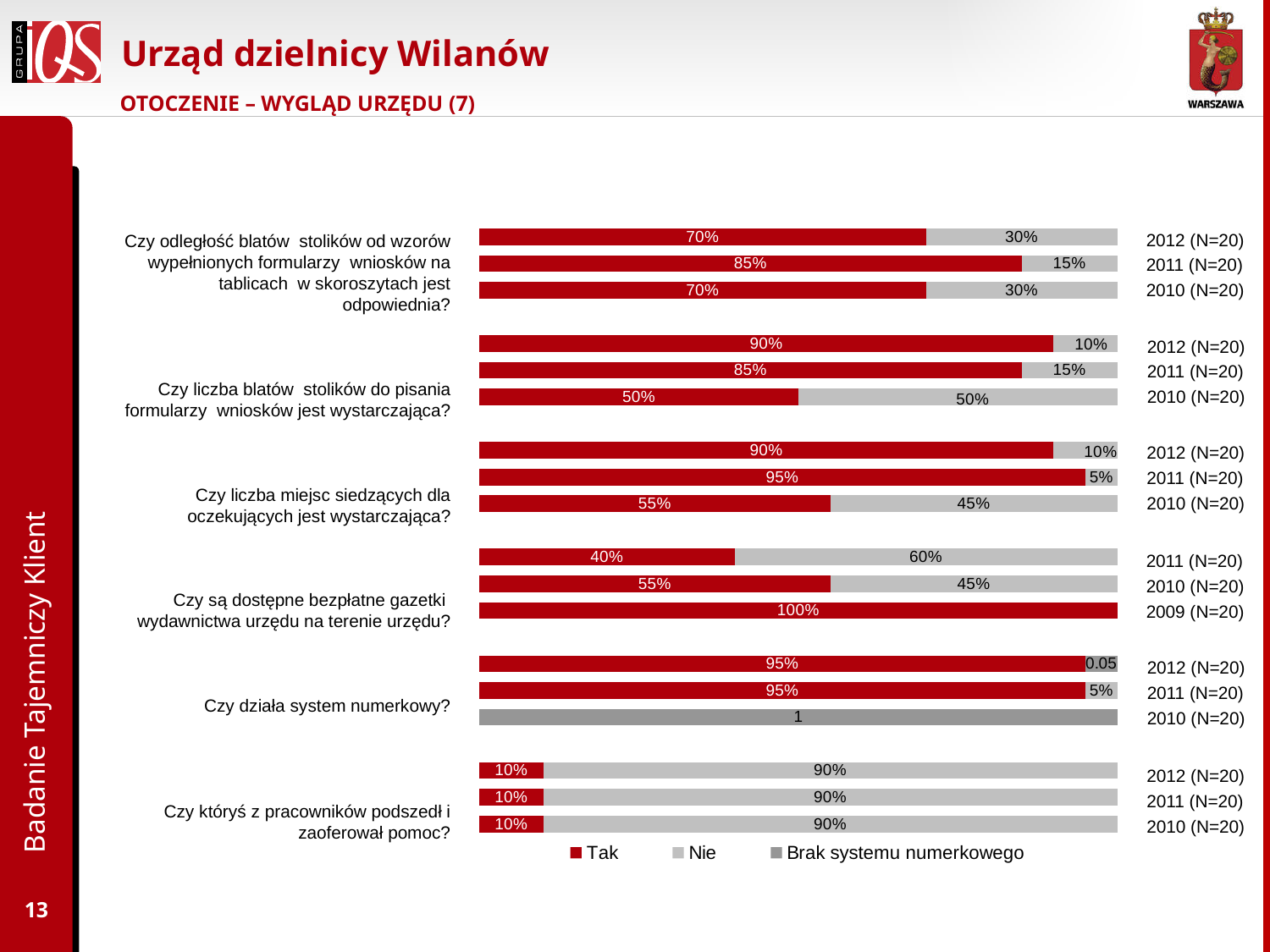
For the question "Czy liczba blatów stolików do pisania formularzy wniosków jest wystarczająca?", what is the Nie value for 2010 (N=20)? 50% For the question "Czy liczba miejsc siedzących dla oczekujących jest wystarczająca?", what is the Tak value for 2011 (N=20)? 95% For the question "Czy odległość blatów stolików od wzorów wypełnionych formularzy wniosków na tablicach w skoroszytach jest odpowiednia?", what is the Tak value for 2011 (N=20)? 85% What kind of chart is shown on the slide? Stacked bar chart For the question "Czy któryś z pracowników podszedł i zaoferował pomoc?", what is the Nie value for 2012 (N=20)? 90% For the question "Czy liczba blatów stolików do pisania formularzy wniosków jest wystarczająca?", does the Tak value rise or fall from 2010 to 2012? Rises For the question "Czy liczba blatów stolików do pisania formularzy wniosków jest wystarczająca?", what is the difference between the Tak value for 2012 and the Tak value for 2010? 40 percentage points For the question "Czy odległość blatów stolików od wzorów wypełnionych formularzy wniosków na tablicach w skoroszytach jest odpowiednia?", which year has the highest Tak value? 2011 How many series does the chart legend list? 3 Which colour represents the Tak series in the chart legend? Red For the question "Czy są dostępne bezpłatne gazetki wydawnictwa urzędu na terenie urzędu?", what is the Tak value for 2009 (N=20)? 100% For the question "Czy liczba miejsc siedzących dla oczekujących jest wystarczająca?", which year has the larger Tak value, 2010 or 2012? 2012